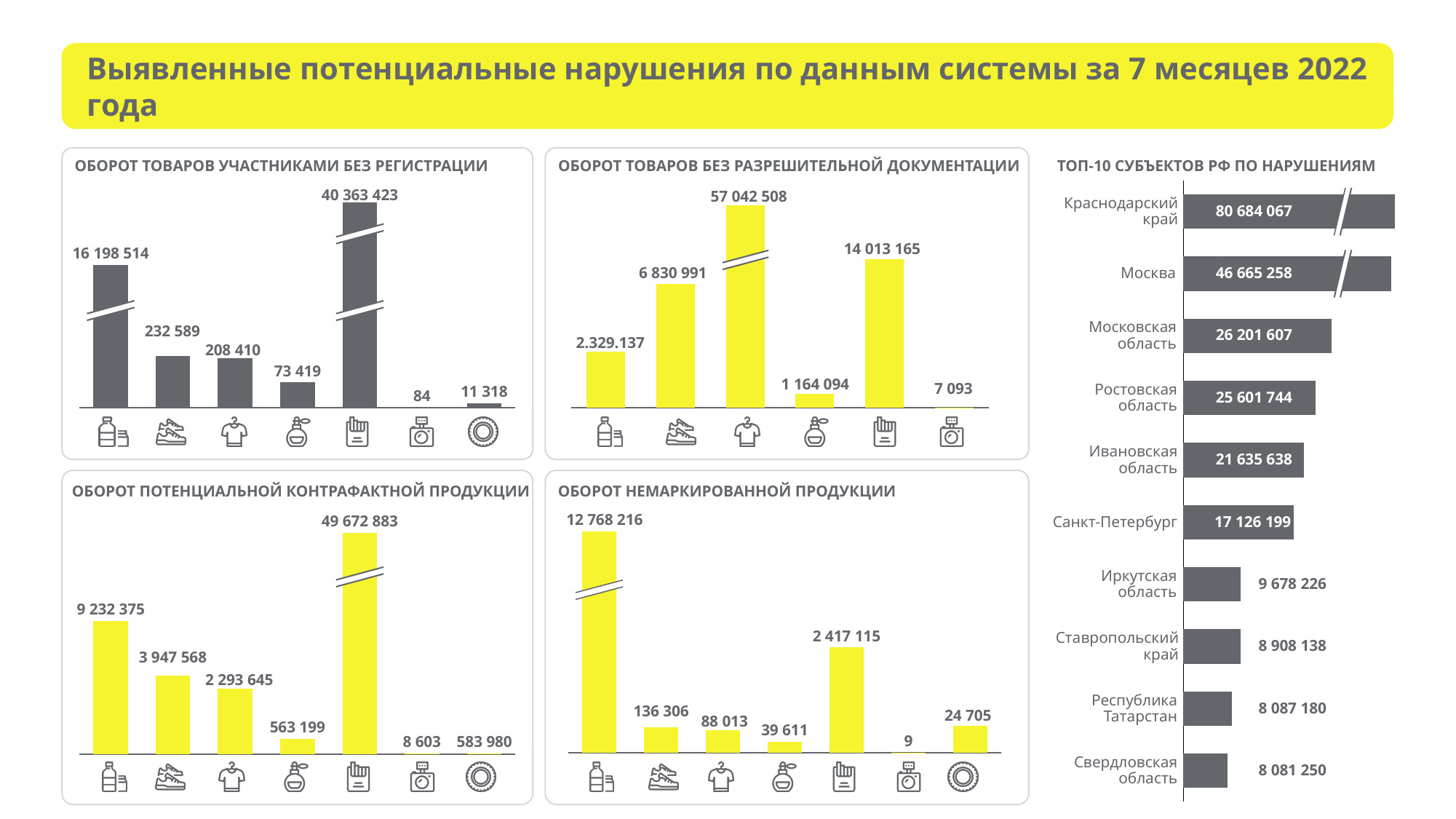
In the chart 'ОБОРОТ ПОТЕНЦИАЛЬНОЙ КОНТРАФАКТНОЙ ПРОДУКЦИИ', what is the lowest value shown? 8 603 In the chart 'ТОП-10 СУБЪЕКТОВ РФ ПО НАРУШЕНИЯМ', what is the difference between the values for Краснодарский край and Москва? 34 018 809 How many regions are shown in the chart 'ТОП-10 СУБЪЕКТОВ РФ ПО НАРУШЕНИЯМ'? 10 In the chart 'ОБОРОТ ТОВАРОВ УЧАСТНИКАМИ БЕЗ РЕГИСТРАЦИИ', what is the highest value shown? 40 363 423 In the chart 'ТОП-10 СУБЪЕКТОВ РФ ПО НАРУШЕНИЯМ', what is the value for Москва? 46 665 258 In the chart 'ТОП-10 СУБЪЕКТОВ РФ ПО НАРУШЕНИЯМ', which region has the highest value? Краснодарский край In the chart 'ТОП-10 СУБЪЕКТОВ РФ ПО НАРУШЕНИЯМ', what is the value for Санкт-Петербург? 17 126 199 In the chart 'ОБОРОТ НЕМАРКИРОВАННОЙ ПРОДУКЦИИ', what is the value of the first bar from the left? 12 768 216 What kind of chart is 'ТОП-10 СУБЪЕКТОВ РФ ПО НАРУШЕНИЯМ'? Bar chart In the chart 'ТОП-10 СУБЪЕКТОВ РФ ПО НАРУШЕНИЯМ', which is larger: the value for Ростовская область or the value for Ивановская область? Ростовская область In the chart 'ОБОРОТ ТОВАРОВ БЕЗ РАЗРЕШИТЕЛЬНОЙ ДОКУМЕНТАЦИИ', how many bars are shown? 6 In the chart 'ТОП-10 СУБЪЕКТОВ РФ ПО НАРУШЕНИЯМ', which region has the lowest value? Свердловская область